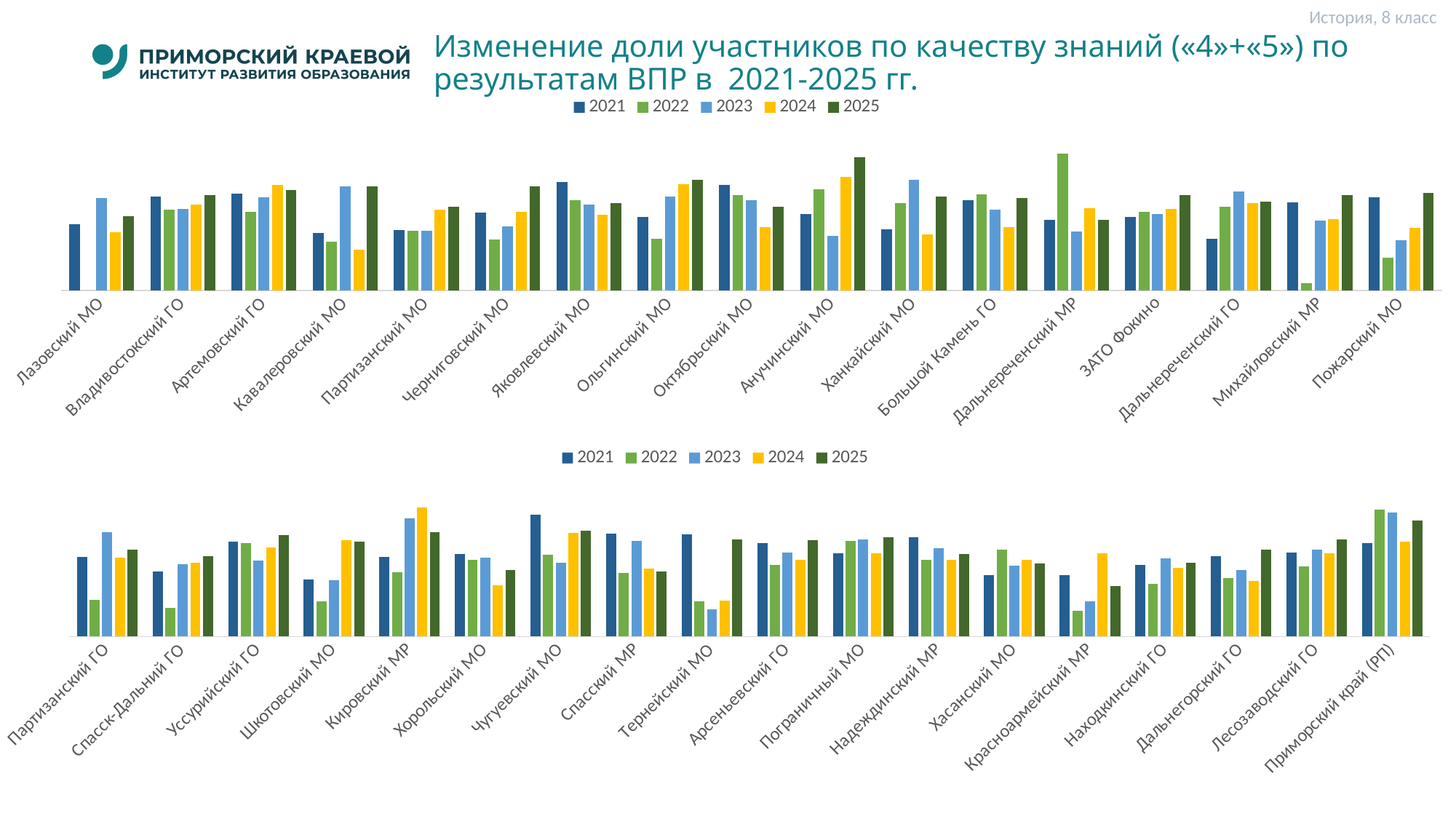
In the top chart, which category has the tallest bar overall? Дальнереченский МР How many series does the legend of the top chart list? 5 In the top chart, for Кавалеровский МО, which is larger: the 2023 value or the 2024 value? 2023 Which years are listed in the legend of the bottom chart? 2021, 2022, 2023, 2024, 2025 In the bottom chart, which year has the highest value for Чугуевский МО? 2021 In the bottom chart, which year has the highest value for Кировский МР? 2024 How many categories are shown on the x axis of the bottom chart? 18 In the top chart, which category has the shortest bar overall? Михайловский МР What kind of chart is the top chart on the slide? Bar chart How many categories (municipalities) are shown on the x axis of the top chart? 17 In the bottom chart, for Тернейский МО, which is larger: the 2021 value or the 2023 value? 2021